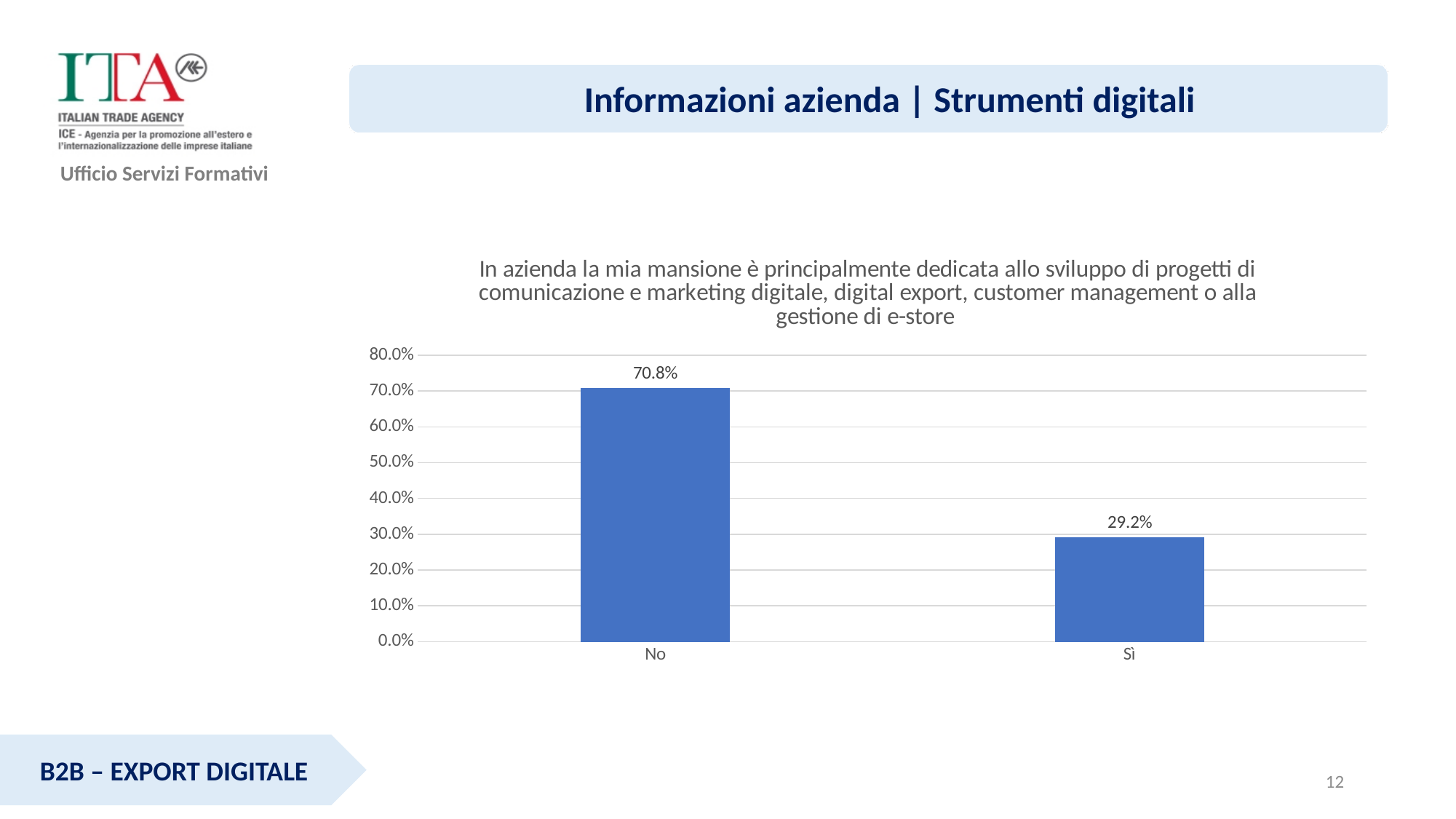
What kind of chart is shown on the slide? Bar chart Is the value for "No" greater or less than 70.0%? greater What is the value for "Sì"? 29.2% What is the value for "No"? 70.8% How many categories are shown on the x axis? 2 What is the highest value shown on the y axis? 80.0% Which is larger, the value for "No" or the value for "Sì"? No Is the value for "Sì" greater or less than 30.0%? less What is the difference between the values for "No" and "Sì"? 41.6% What is the total of the two bar values? 100.0% Which category has the highest value? No Which category has the lowest value? Sì